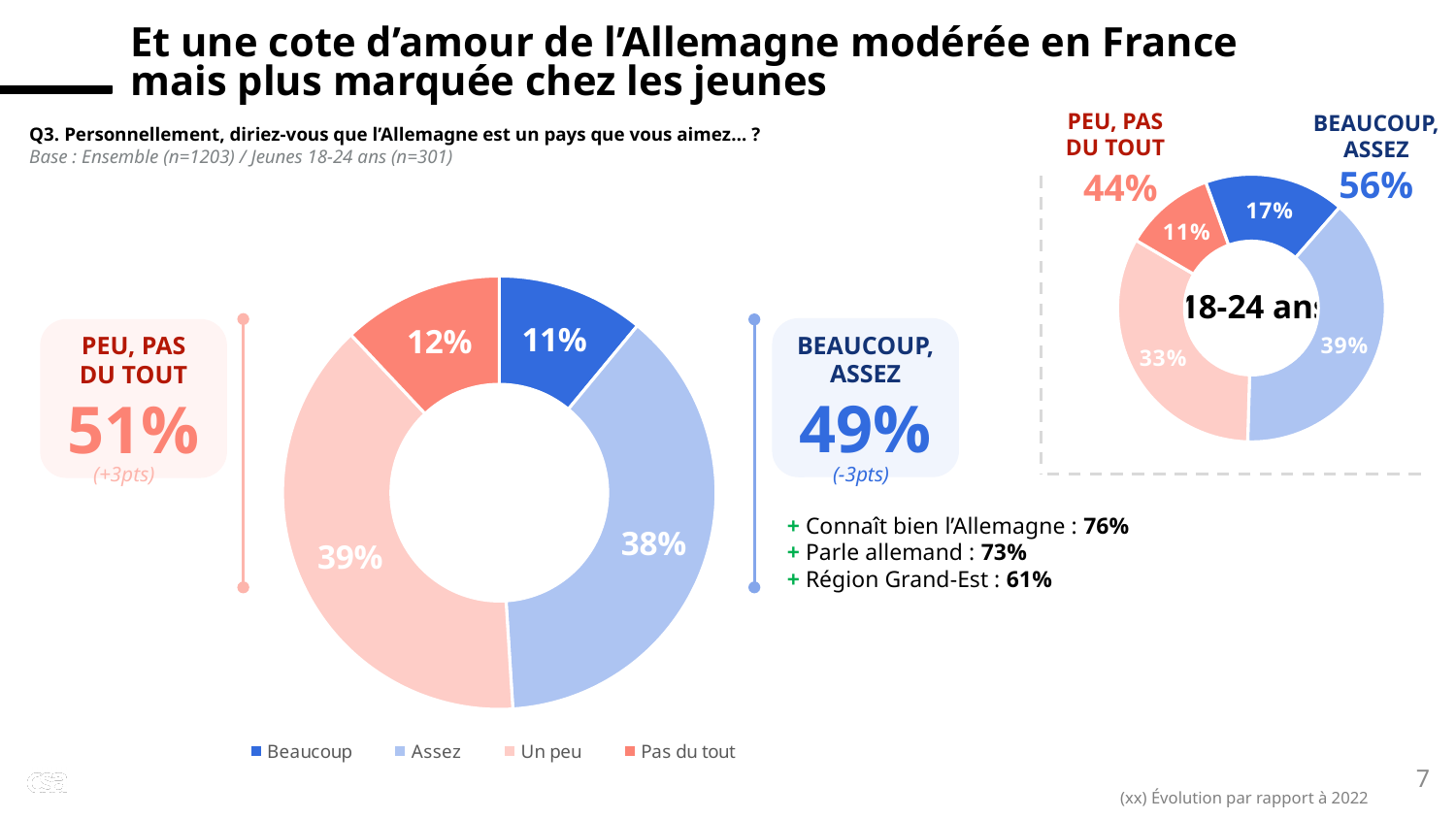
Which colour represents "Pas du tout" in the legend? Salmon/red In the large donut chart on the left, what is the value for "Assez"? 38% In the small donut chart in the top right (18-24 ans), what is the difference between "Assez" and "Pas du tout"? 28% In the large donut chart on the left, what is the value for "Pas du tout"? 12% In the small donut chart in the top right (18-24 ans), what is the value for "Un peu"? 33% How many series does the legend at the bottom of the slide list? 4 In the large donut chart on the left, what is the difference between "Un peu" and "Beaucoup"? 28% In the small donut chart in the top right (18-24 ans), which category has the highest value? Assez In the large donut chart on the left, which category has the lowest value? Beaucoup What kind of chart is the large chart on the left? Donut (pie) chart In the small donut chart in the top right (18-24 ans), what is the value for "Beaucoup"? 17% In the large donut chart on the left, which is larger, "Assez" or "Pas du tout"? Assez